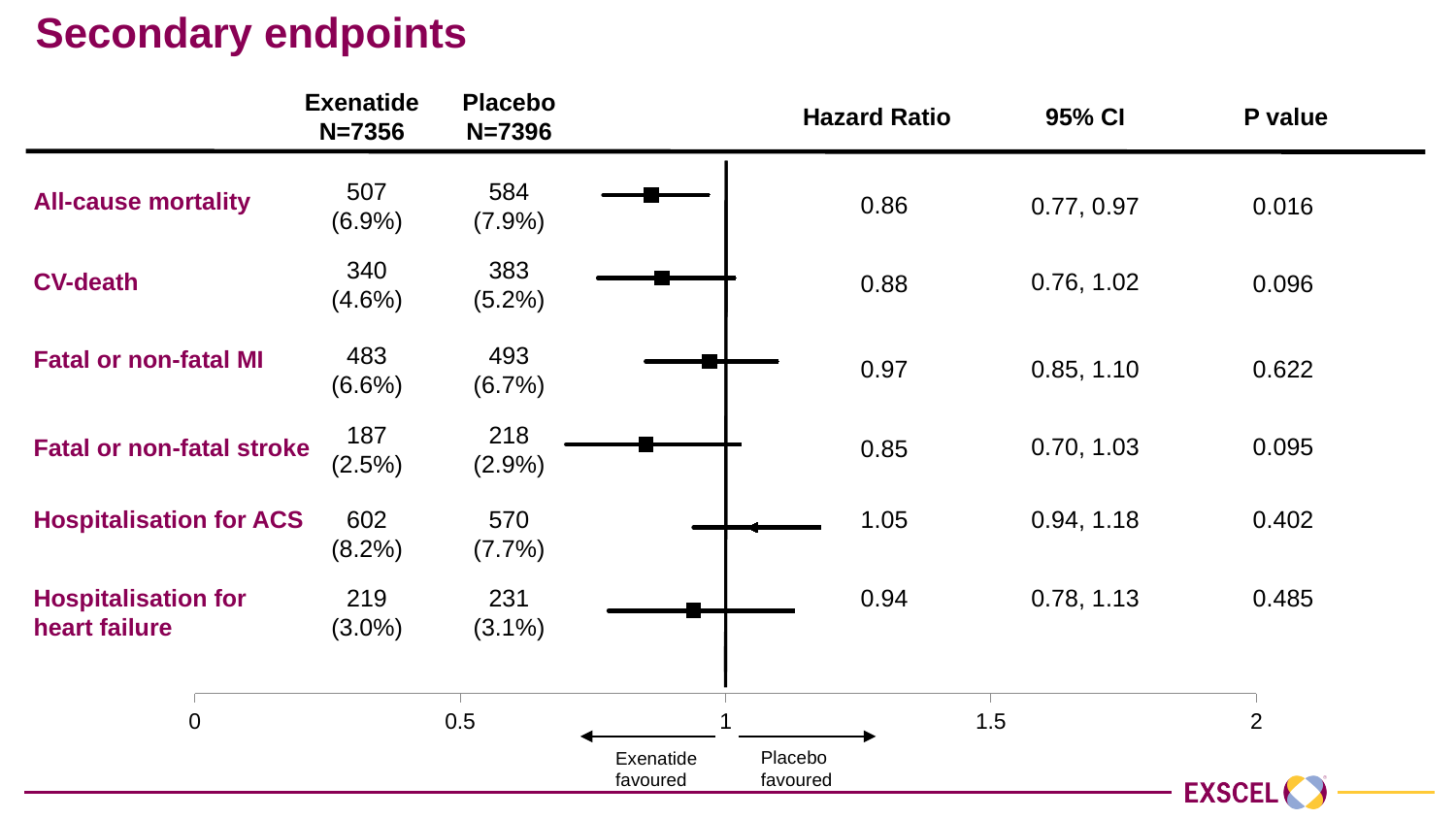
What is the P value for CV-death? 0.096 Which endpoint has the lowest hazard ratio? Fatal or non-fatal stroke How many secondary endpoints are plotted on the chart? 6 What is the difference between the Placebo and Exenatide event counts for All-cause mortality? 77 How many patients in the Placebo group had Hospitalisation for ACS? 570 (7.7%) Which endpoint has the highest hazard ratio? Hospitalisation for ACS Which has the larger hazard ratio, Fatal or non-fatal MI or CV-death? Fatal or non-fatal MI What is the hazard ratio for All-cause mortality? 0.86 What is the 95% CI for Fatal or non-fatal stroke? 0.70, 1.03 What does the left side of the x axis (below 1) indicate according to the label? Exenatide favoured What kind of chart is shown on the slide? Forest plot Is the hazard ratio for Hospitalisation for ACS greater or less than 1? greater